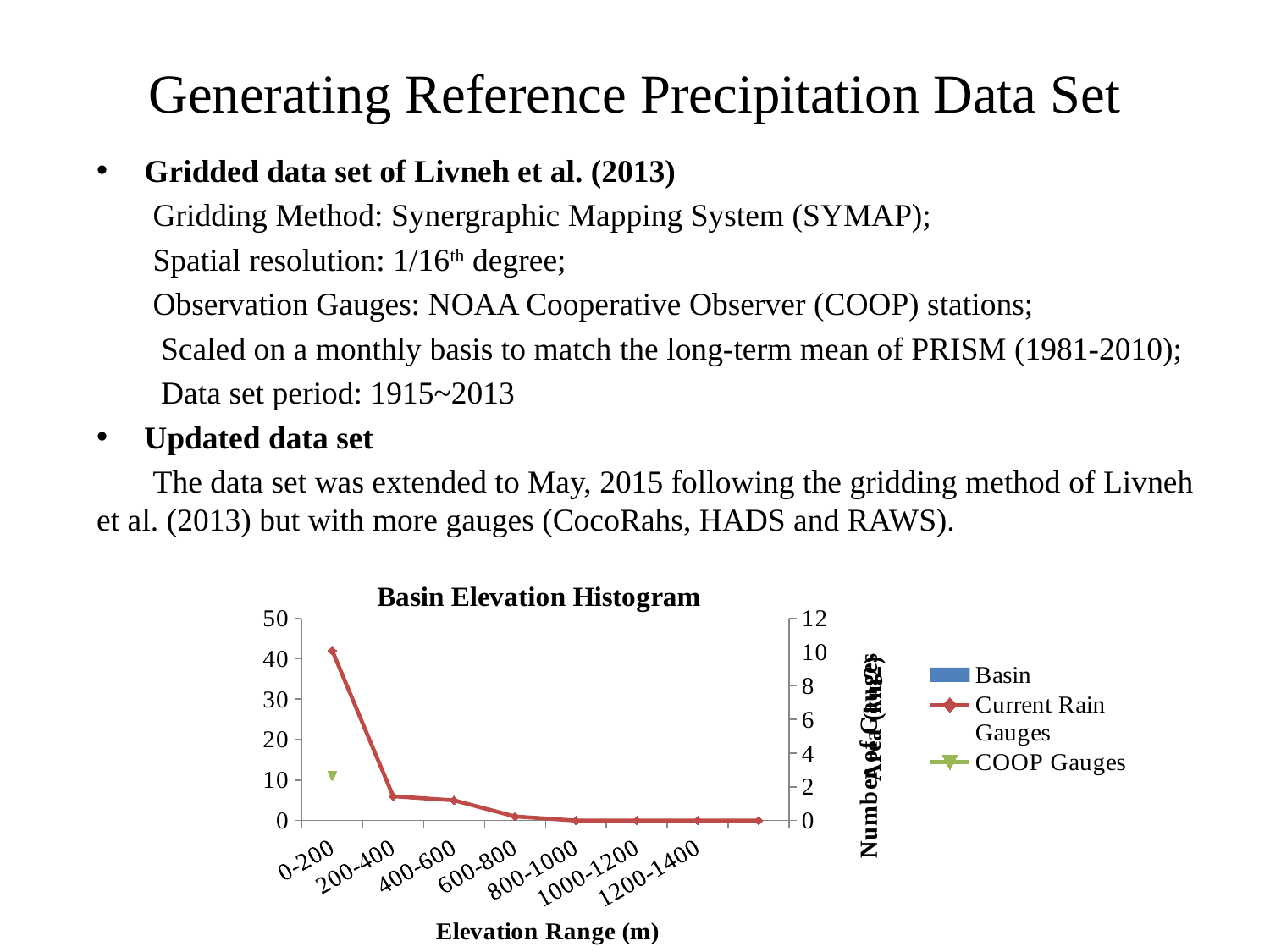
In the Basin Elevation Histogram chart, which elevation range has the highest value for Current Rain Gauges? 0-200 What is the title of the chart on the slide? Basin Elevation Histogram How many series does the legend of the Basin Elevation Histogram chart list? 3 In the Basin Elevation Histogram chart, is the Current Rain Gauges value for 200-400 greater or less than 10? less What is the x-axis title of the Basin Elevation Histogram chart? Elevation Range (m) In the Basin Elevation Histogram chart, which is larger for Current Rain Gauges: the value at 0-200 or the value at 400-600? 0-200 What kind of chart is the Basin Elevation Histogram, based on the plotted data? line chart In the Basin Elevation Histogram chart, which is larger for Current Rain Gauges: the value at 200-400 or the value at 1000-1200? 200-400 In the Basin Elevation Histogram chart, is the Current Rain Gauges value for 1200-1400 greater or less than 10? less In the Basin Elevation Histogram chart, do the Current Rain Gauges values rise or fall as elevation range increases along the x axis? fall